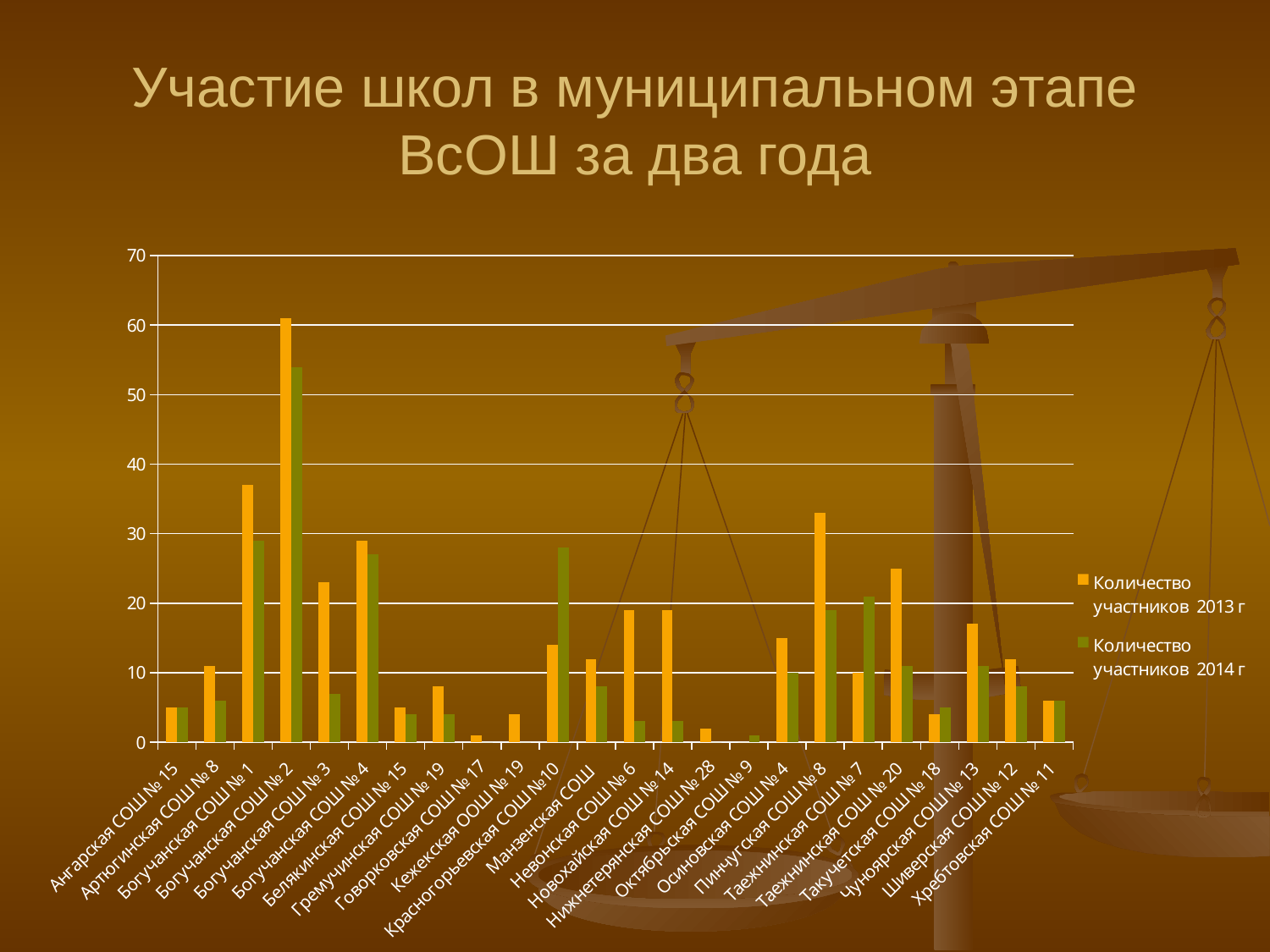
What kind of chart is shown on the slide? bar chart How many schools (categories) are shown on the x axis? 24 Which school has the highest number of participants in 2013? Богучанская СОШ № 2 How many series does the legend list? 2 Which school has the highest number of participants in 2014? Богучанская СОШ № 2 Which colour represents the 2014 participants series in the legend? green Is the 2013 value for Пинчугская СОШ № 8 greater or less than 30? greater Is the 2014 value for Ангарская СОШ № 15 greater or less than 10? less For Богучанская СОШ № 1, which year had more participants, 2013 or 2014? 2013 Is the 2013 value for Богучанская СОШ № 1 greater or less than 30? greater For Красногорьевская СОШ №10, which year had more participants, 2013 or 2014? 2014